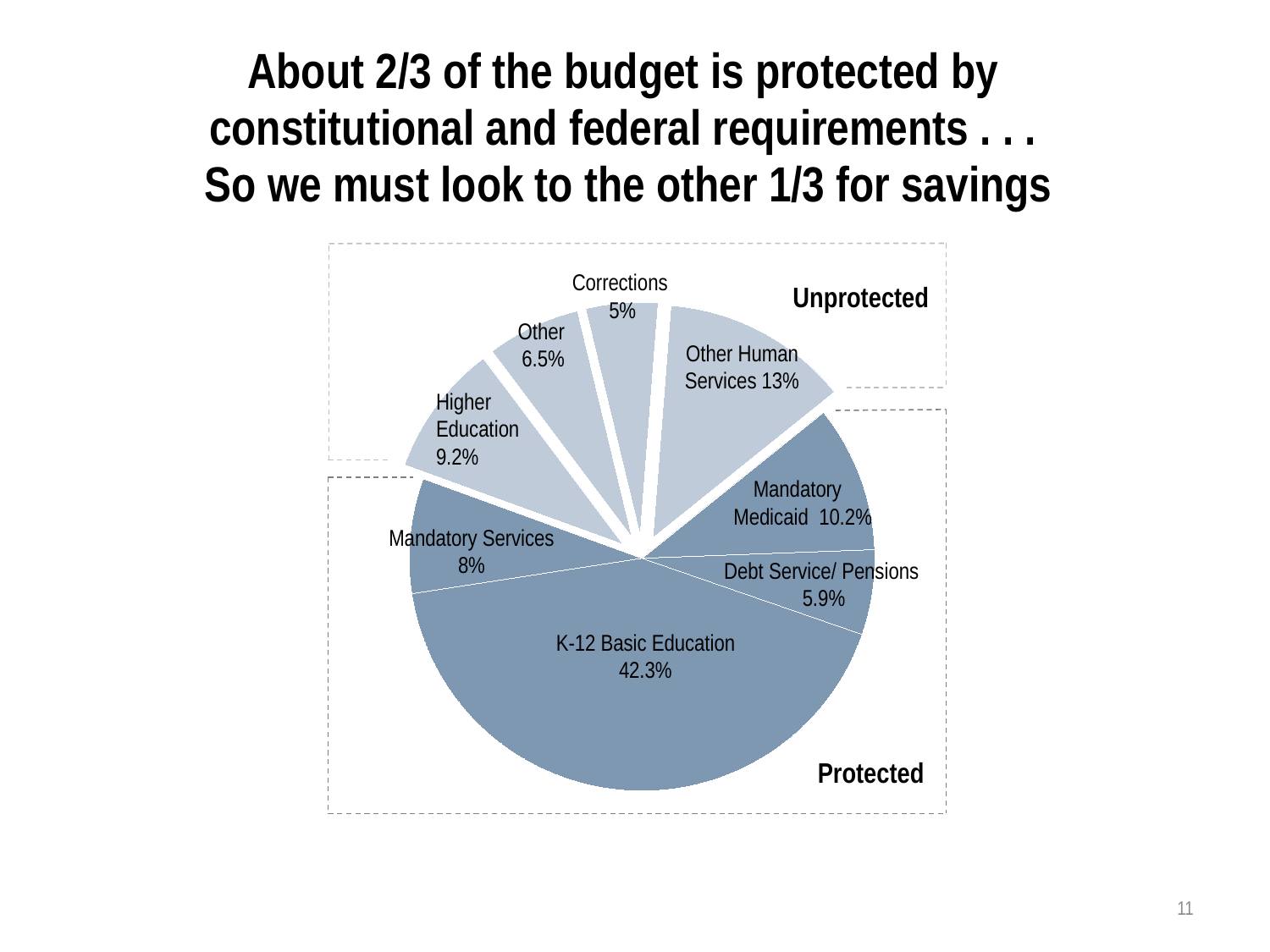
What is the combined percentage of the Unprotected slices (Corrections, Other, Higher Education, Other Human Services)? 33.7% Which slice of the pie is the smallest? Corrections Which two groups are the slices of the pie divided into, according to the labels on the slide? Unprotected and Protected What percentage is shown for Higher Education? 9.2% How many slices does the pie chart have? 8 Which slice of the pie is the largest? K-12 Basic Education Which is larger, the share for Other or the share for Corrections? Other What percentage is shown for Debt Service/ Pensions? 5.9% What is the difference in percentage points between Other Human Services and Mandatory Services? 5 What percentage is shown for Mandatory Medicaid? 10.2% What share of the budget does K-12 Basic Education represent? 42.3% What kind of chart is shown on the slide? Pie chart